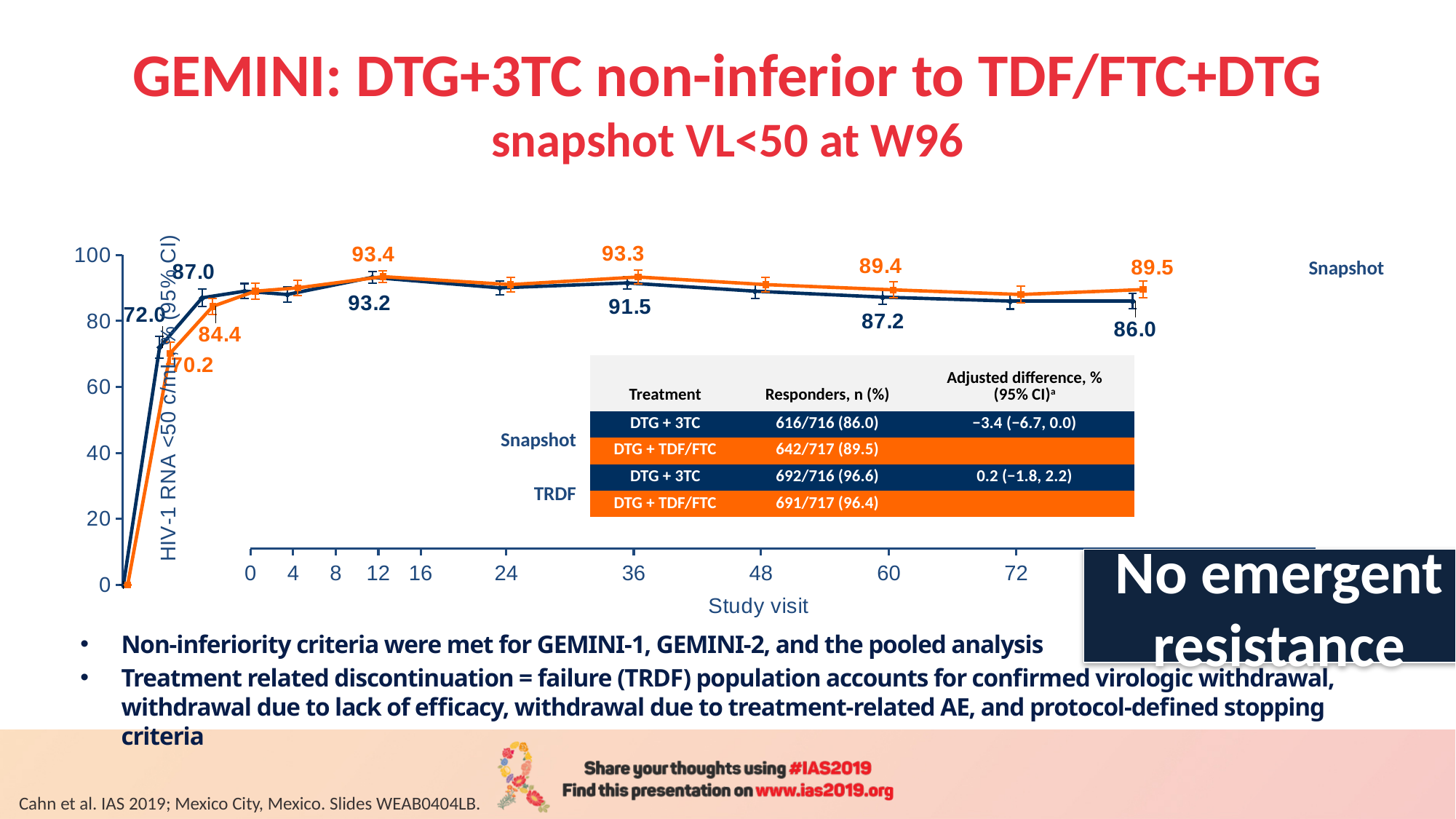
How many lines (treatment arms) are plotted on the chart? 2 At the final labelled point, which line is higher, the navy (DTG + 3TC) or the orange (DTG + TDF/FTC)? orange (DTG + TDF/FTC) What is the highest labelled value on the orange line (DTG + TDF/FTC)? 93.4 What is the lowest labelled value on the navy line (DTG + 3TC)? 72.0 What kind of chart is shown on the slide? line chart What is the difference between the final labelled values of the orange line (89.5) and the navy line (86.0)? 3.5 What is the highest labelled value on the navy line (DTG + 3TC)? 93.2 What is the lowest labelled value on the orange line (DTG + TDF/FTC)? 70.2 Is the final labelled value on the navy line greater or less than 80? greater What is the final labelled value (snapshot) on the navy line (DTG + 3TC)? 86.0 What is the title of the x axis of the chart? Study visit What is the final labelled value (snapshot) on the orange line (DTG + TDF/FTC)? 89.5